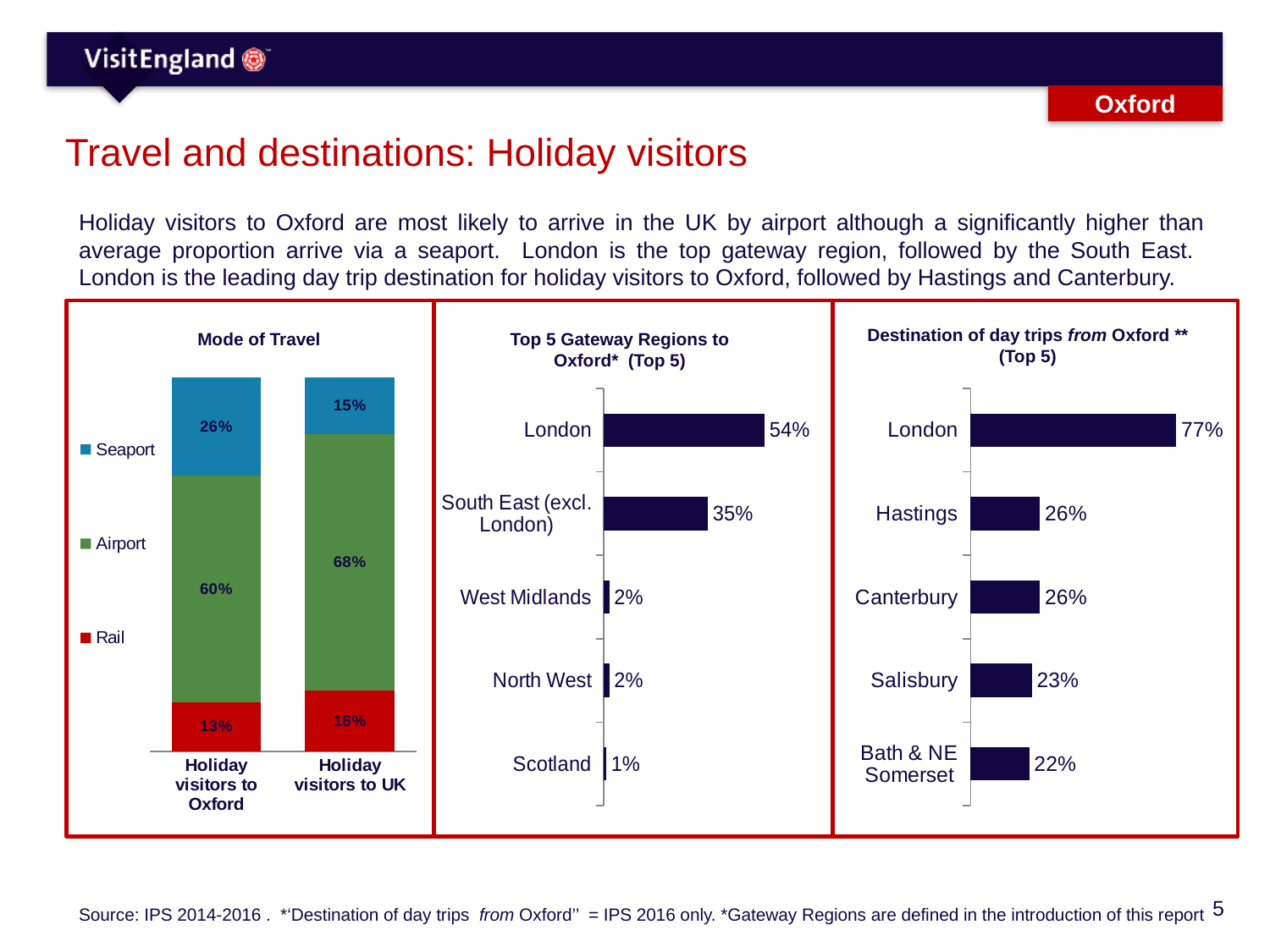
In the Mode of Travel chart, what is the difference between the seaport share for holiday visitors to Oxford and for holiday visitors to UK? 11% In the Destination of day trips from Oxford chart, how many destinations are shown? 5 In the Mode of Travel chart, how many series does the legend list? 3 In the Destination of day trips from Oxford chart, what is the value for Salisbury? 23% In the Mode of Travel chart, which is larger: the rail share for holiday visitors to Oxford or for holiday visitors to UK? Holiday visitors to UK In the Top 5 Gateway Regions to Oxford chart, which region has the lowest value? Scotland What kind of chart is the Destination of day trips from Oxford chart? Bar chart In the Destination of day trips from Oxford chart, which destination has the highest value? London In the Mode of Travel chart, what percentage of holiday visitors to Oxford arrive by seaport? 26% In the Top 5 Gateway Regions to Oxford chart, what is the difference between London and South East (excl. London)? 19% In the Mode of Travel chart, what percentage of holiday visitors to Oxford arrive by airport? 60% In the Top 5 Gateway Regions to Oxford chart, what is the value for South East (excl. London)? 35%